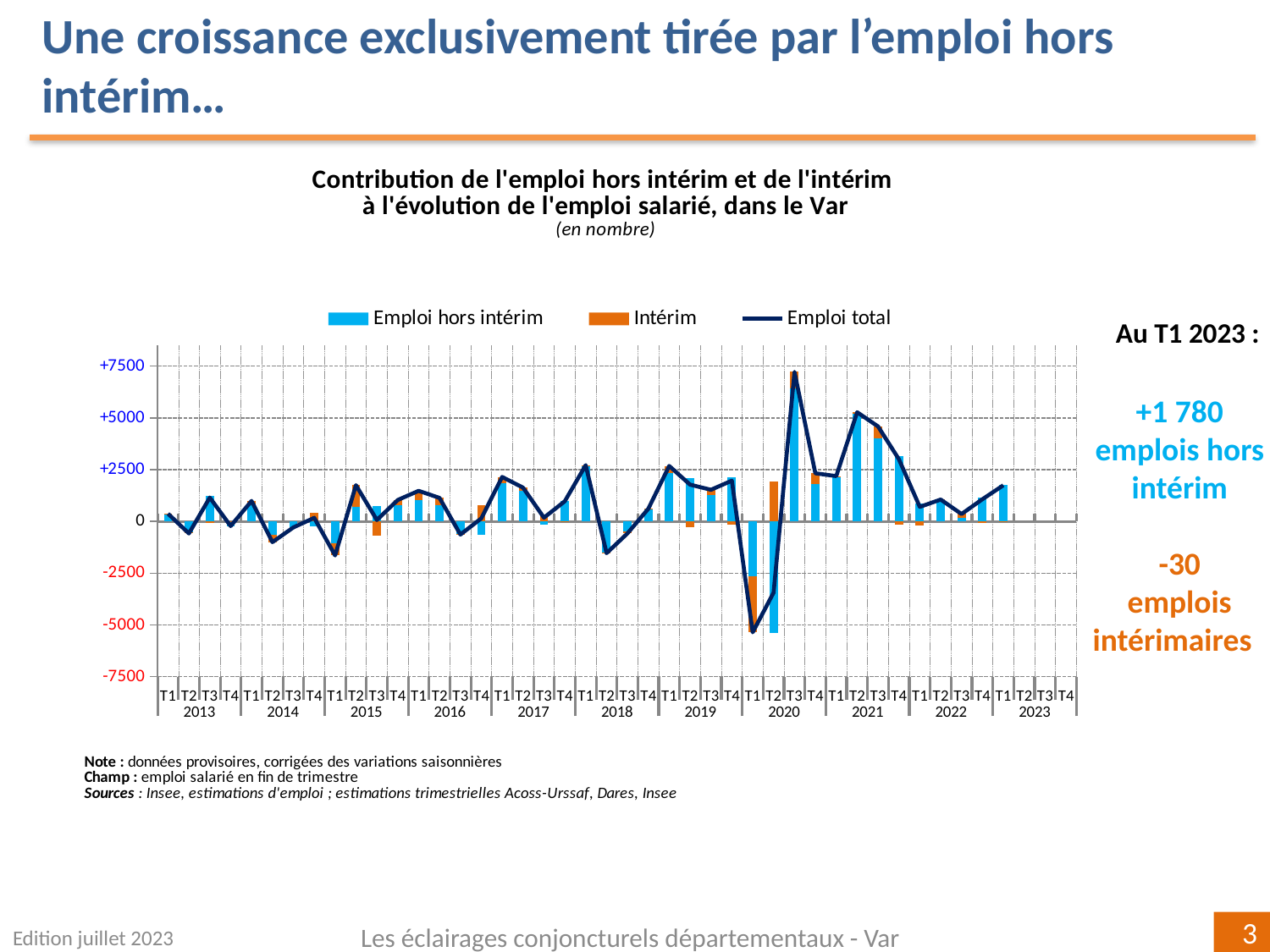
Is the value of the Emploi total line at T3 2020 greater or less than +5000? greater In which quarter does the Emploi total line reach its highest value? T3 2020 Which is larger, the Emploi hors intérim bar at T3 2020 or at T2 2021? T3 2020 Is the value for Emploi hors intérim at T3 2020 greater or less than +5000? greater Is the value for Emploi hors intérim at T2 2020 greater or less than -2500? less What are the three series listed in the chart legend? Emploi hors intérim, Intérim, Emploi total According to the slide, what is the value for Emploi hors intérim at T1 2023? +1 780 How many years are labelled along the x axis of the chart? 11 According to the slide, what is the value for Intérim (emplois intérimaires) at T1 2023? -30 How many series does the chart legend list? 3 What kind of chart is shown on the slide? A combined bar and line chart In which quarter does the Emploi total line reach its lowest value? T1 2020